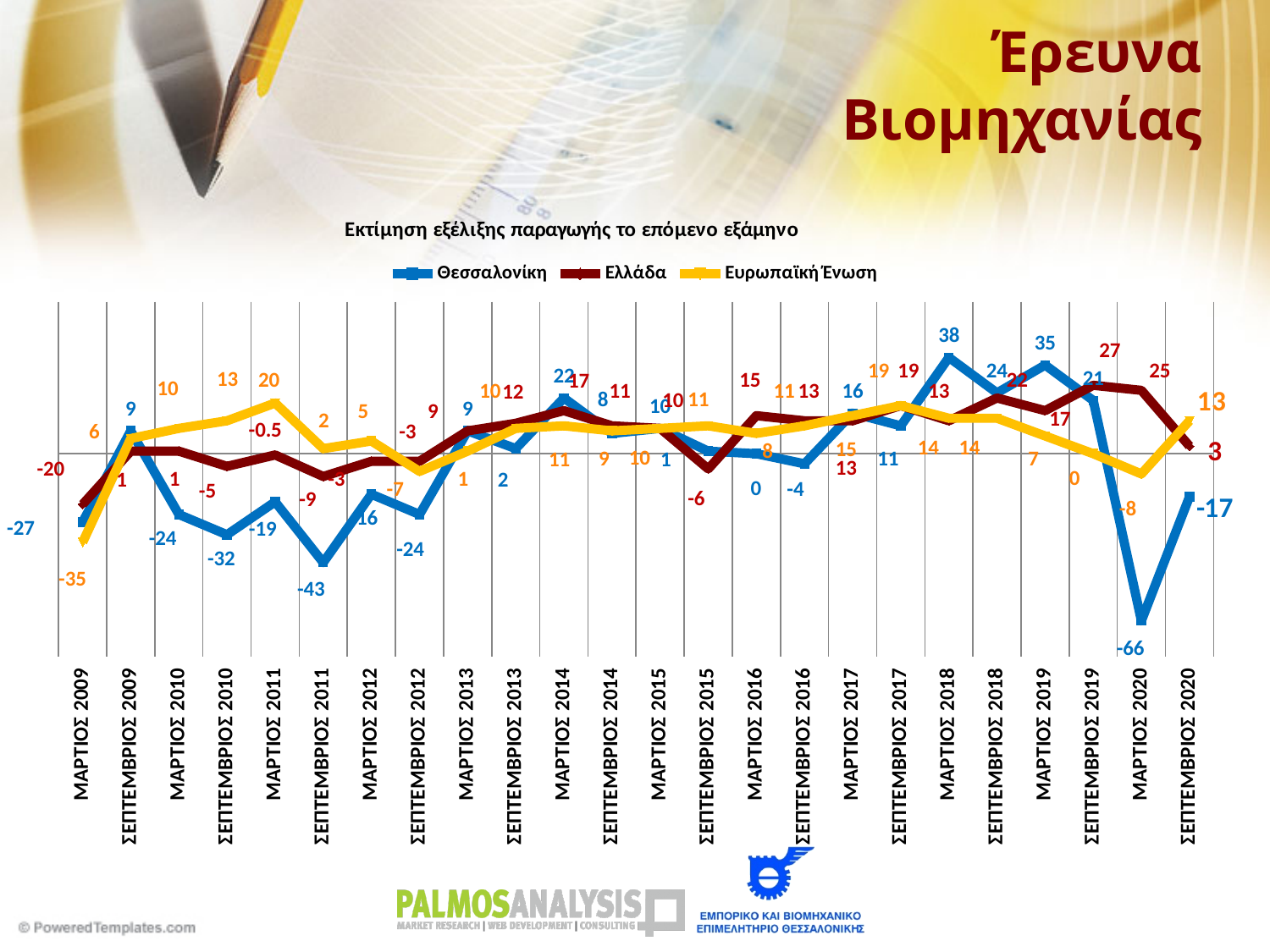
In which period does Ευρωπαϊκή Ένωση reach its lowest value? ΜΑΡΤΙΟΣ 2009 What is the title of the chart? Εκτίμηση εξέλιξης παραγωγής το επόμενο εξάμηνο How many time points are shown on the x axis? 24 In which period does Θεσσαλονίκη reach its lowest value? ΜΑΡΤΙΟΣ 2020 In which period does Θεσσαλονίκη reach its highest value? ΜΑΡΤΙΟΣ 2018 What is the value for Θεσσαλονίκη in ΜΑΡΤΙΟΣ 2020? -66 What kind of chart is shown on the slide? Line chart What is the value for Θεσσαλονίκη in ΣΕΠΤΕΜΒΡΙΟΣ 2020? -17 What is the value for Ευρωπαϊκή Ένωση in ΣΕΠΤΕΜΒΡΙΟΣ 2020? 13 What is the value for Ελλάδα in ΣΕΠΤΕΜΒΡΙΟΣ 2020? 3 What is the difference between the Ελλάδα value and the Θεσσαλονίκη value in ΜΑΡΤΙΟΣ 2020? 91 How many series does the legend list? 3